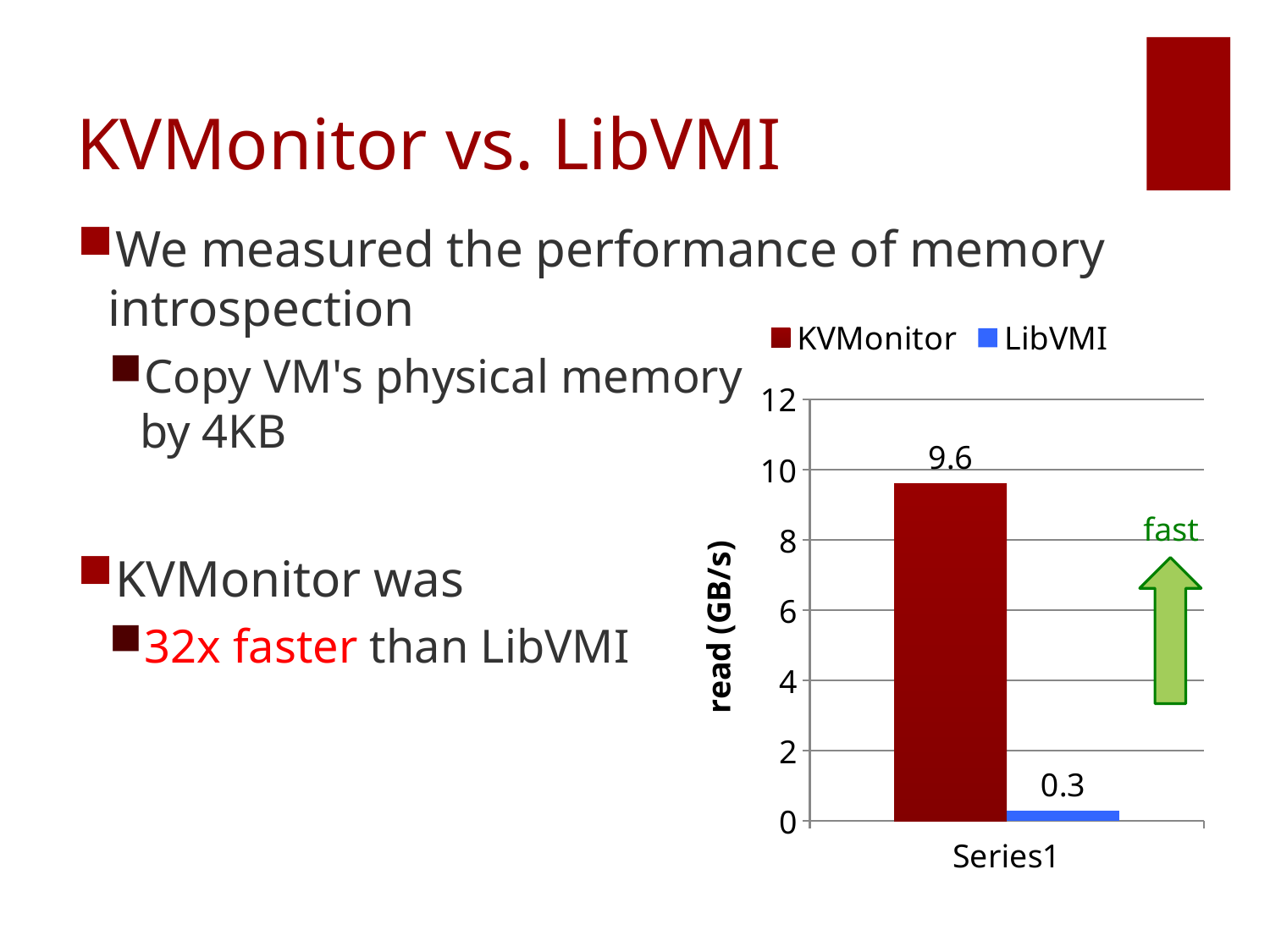
Is the value for KVMonitor greater or less than 8? greater What is the label of the y axis in the chart? read (GB/s) What kind of chart is shown on the slide? bar chart What is the read value for KVMonitor in the chart? 9.6 How many series does the chart legend list? 2 Which series has the lowest read value in the chart? LibVMI Which series has the highest read value in the chart? KVMonitor Which is larger, the read value for KVMonitor or for LibVMI? KVMonitor What colour is the KVMonitor bar in the chart? dark red What is the read value for LibVMI in the chart? 0.3 Is the value for LibVMI greater or less than 2? less What is the difference between the KVMonitor and LibVMI read values? 9.3